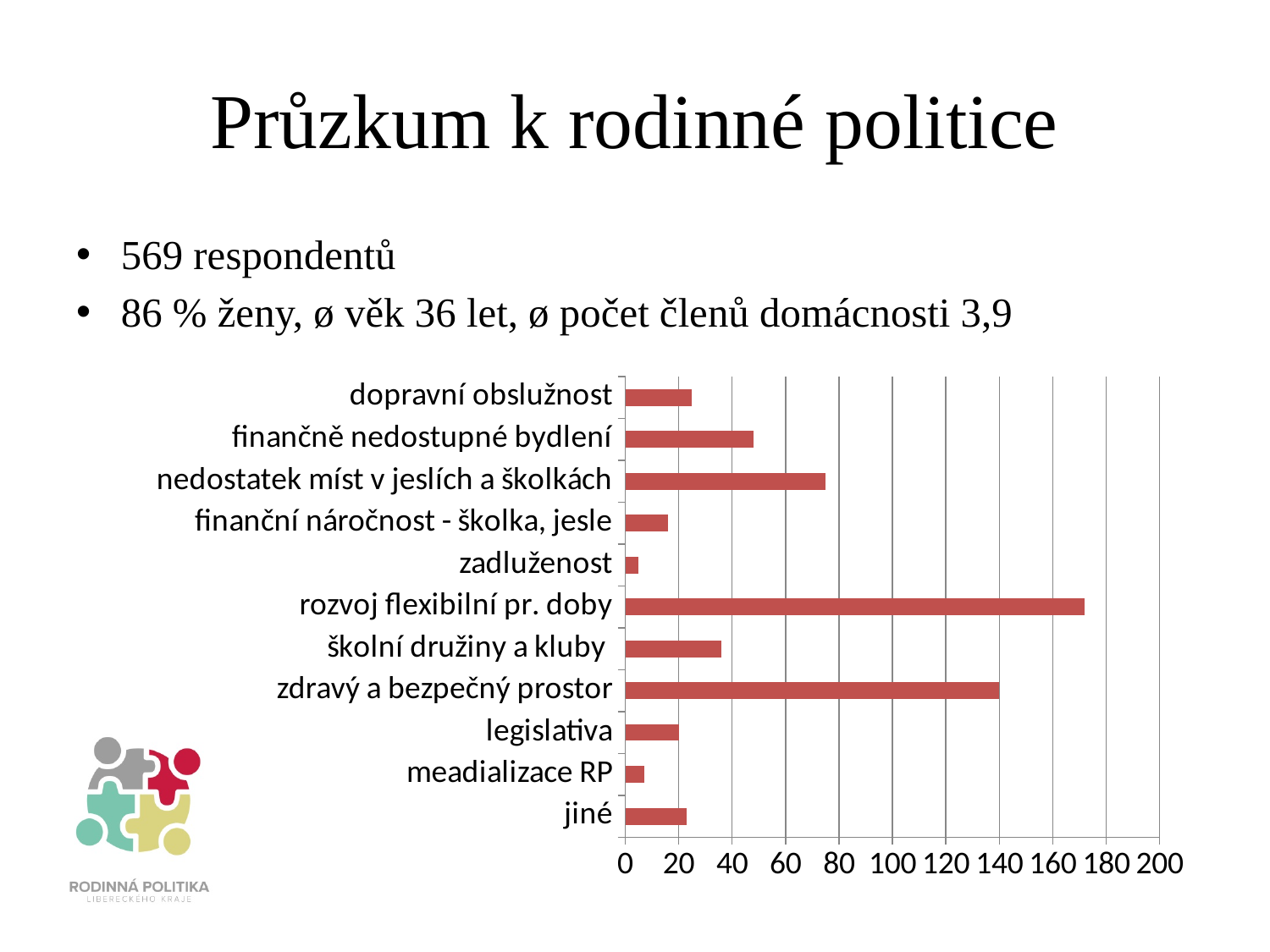
Which category has the highest value in the chart? rozvoj flexibilní pr. doby How many categories are plotted in the chart? 11 Is the value for finančně nedostupné bydlení greater or less than 60? less Is the value for dopravní obslužnost greater or less than 40? less Which is larger, the value for školní družiny a kluby or the value for legislativa? školní družiny a kluby Which category has the lowest value in the chart? zadluženost Which is larger, the value for zdravý a bezpečný prostor or the value for nedostatek míst v jeslích a školkách? zdravý a bezpečný prostor What kind of chart is shown on the slide? bar chart Is the value for nedostatek míst v jeslích a školkách greater or less than 60? greater What is the maximum value shown on the horizontal axis of the chart? 200